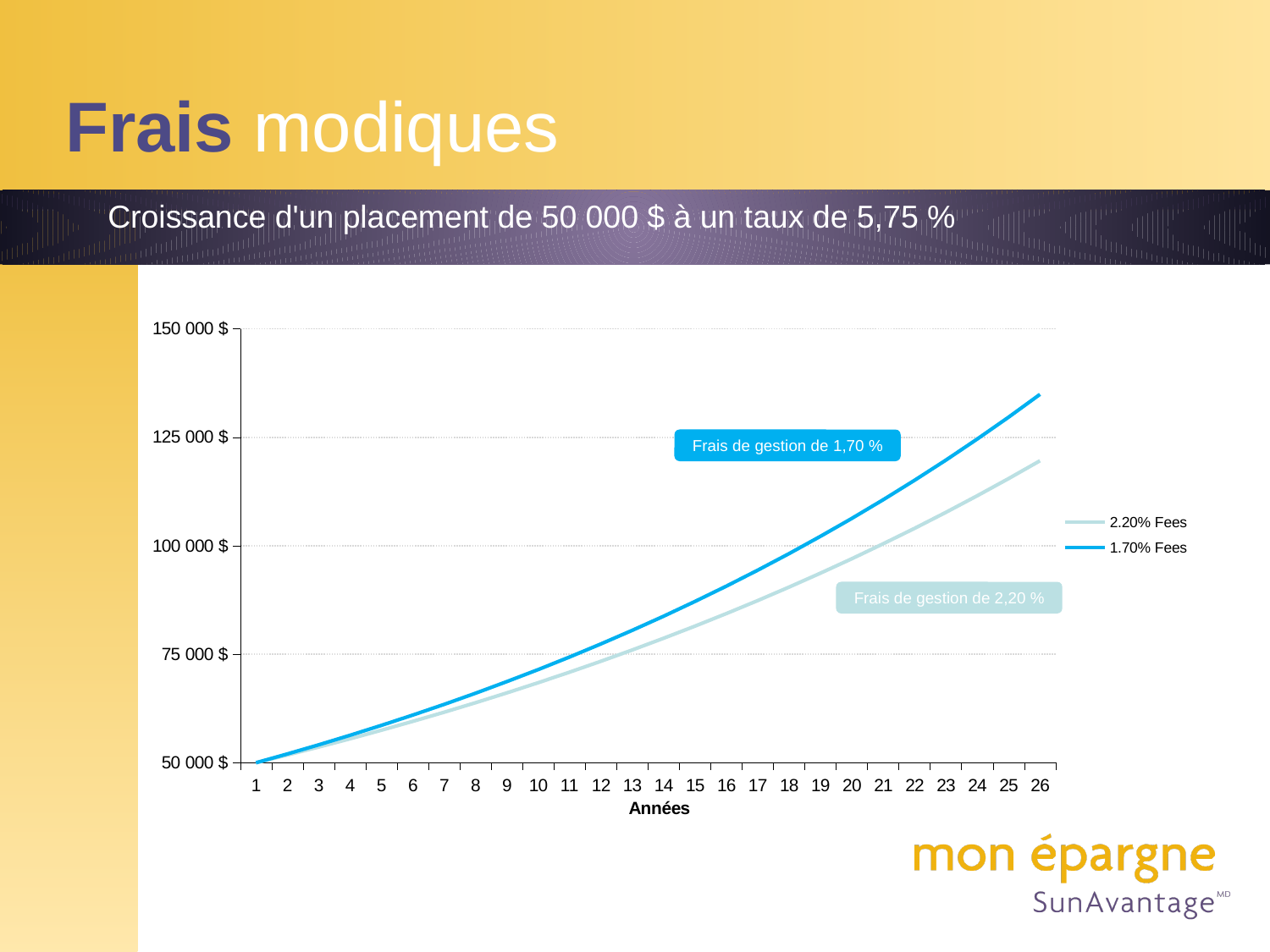
Do the values of the 1.70% Fees series rise or fall as the years increase? rise What is the title of the x axis? Années Which series has the higher value at year 26? 1.70% Fees Is the value of the 2.20% Fees series at year 10 greater or less than 75 000 $? less Is the value of the 1.70% Fees series at year 26 greater or less than 125 000 $? greater Is the value of the 2.20% Fees series at year 26 greater or less than 125 000 $? less What kind of chart is shown on the slide? line chart How many years are plotted along the x axis? 26 What is the value of both series at year 1? 50 000 $ What are the two entries in the chart legend? 2.20% Fees and 1.70% Fees How many series does the legend list? 2